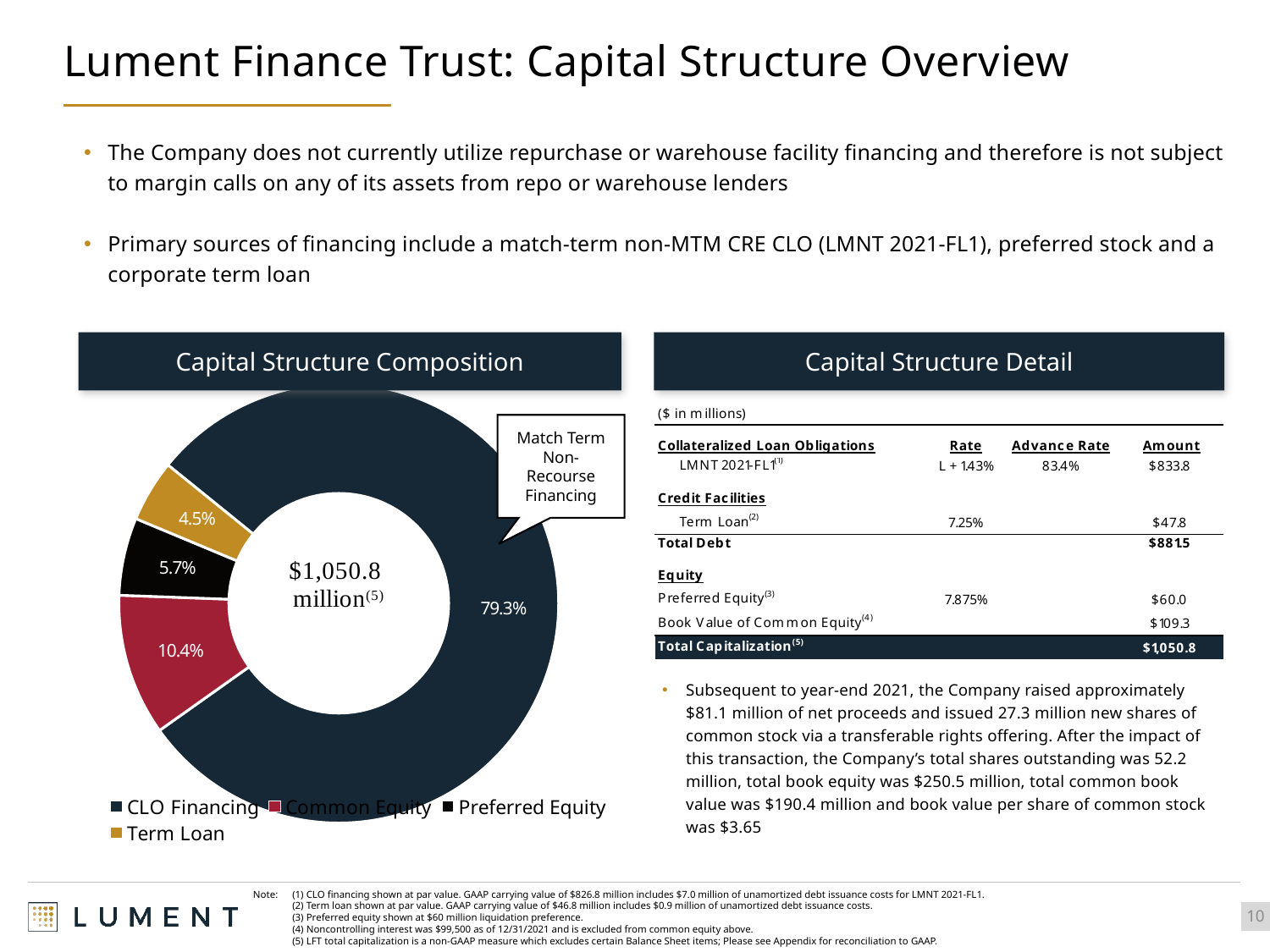
In the Capital Structure Composition chart, what is the difference in percentage points between the CLO Financing and Common Equity slices? 68.9 percentage points What does the callout label attached to the largest slice of the Capital Structure Composition chart say? Match Term Non-Recourse Financing Which category has the smallest slice in the Capital Structure Composition chart? Term Loan Which category has the largest slice in the Capital Structure Composition chart? CLO Financing What kind of chart is shown under "Capital Structure Composition"? Pie chart (donut) In the Capital Structure Composition chart, which slice is larger: Preferred Equity or Term Loan? Preferred Equity In the Capital Structure Composition chart, what share does Term Loan represent? 4.5% In the Capital Structure Composition chart, what share does CLO Financing represent? 79.3% How many categories does the legend of the Capital Structure Composition chart list? 4 In the Capital Structure Composition chart, what share does Common Equity represent? 10.4% What total value is printed in the center of the Capital Structure Composition donut chart? $1,050.8 million In the Capital Structure Composition chart, what share does Preferred Equity represent? 5.7%